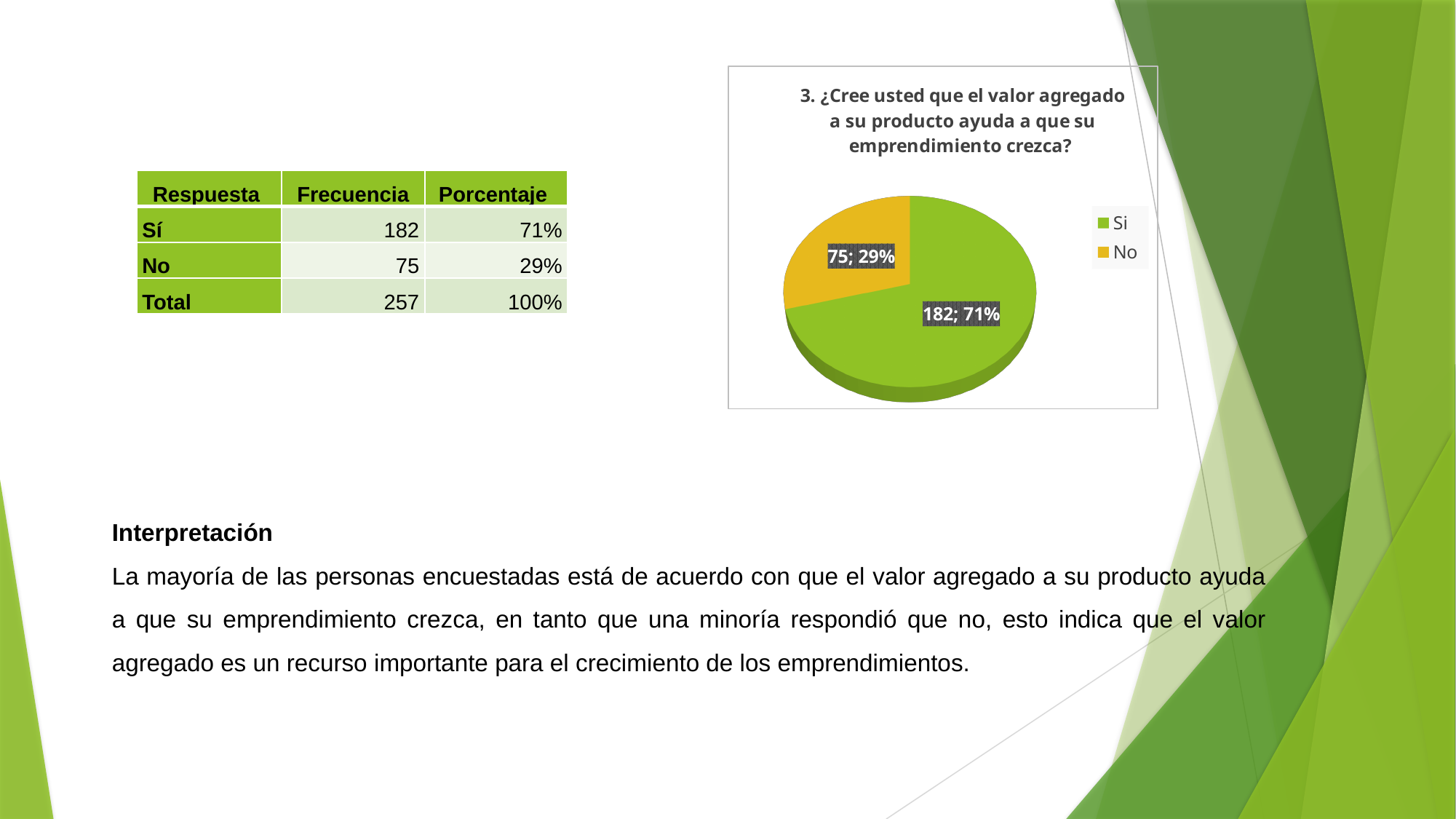
How many entries does the legend of the pie chart list? 2 Which slice of the pie chart is the largest? Si What is the difference between the frequency values for 'Si' and 'No' in the pie chart? 107 What percentage share of the pie does the 'No' slice represent? 29% What percentage share of the pie does the 'Si' slice represent? 71% How many slices does the pie chart have? 2 What colour is the 'No' slice in the pie chart? yellow/orange Which slice of the pie chart is the smallest? No What is the frequency value shown for the 'No' slice of the pie chart? 75 What is the frequency value shown for the 'Si' slice of the pie chart? 182 What kind of chart is shown on the slide? pie chart Which is larger in the pie chart, the value for 'Si' or the value for 'No'? Si